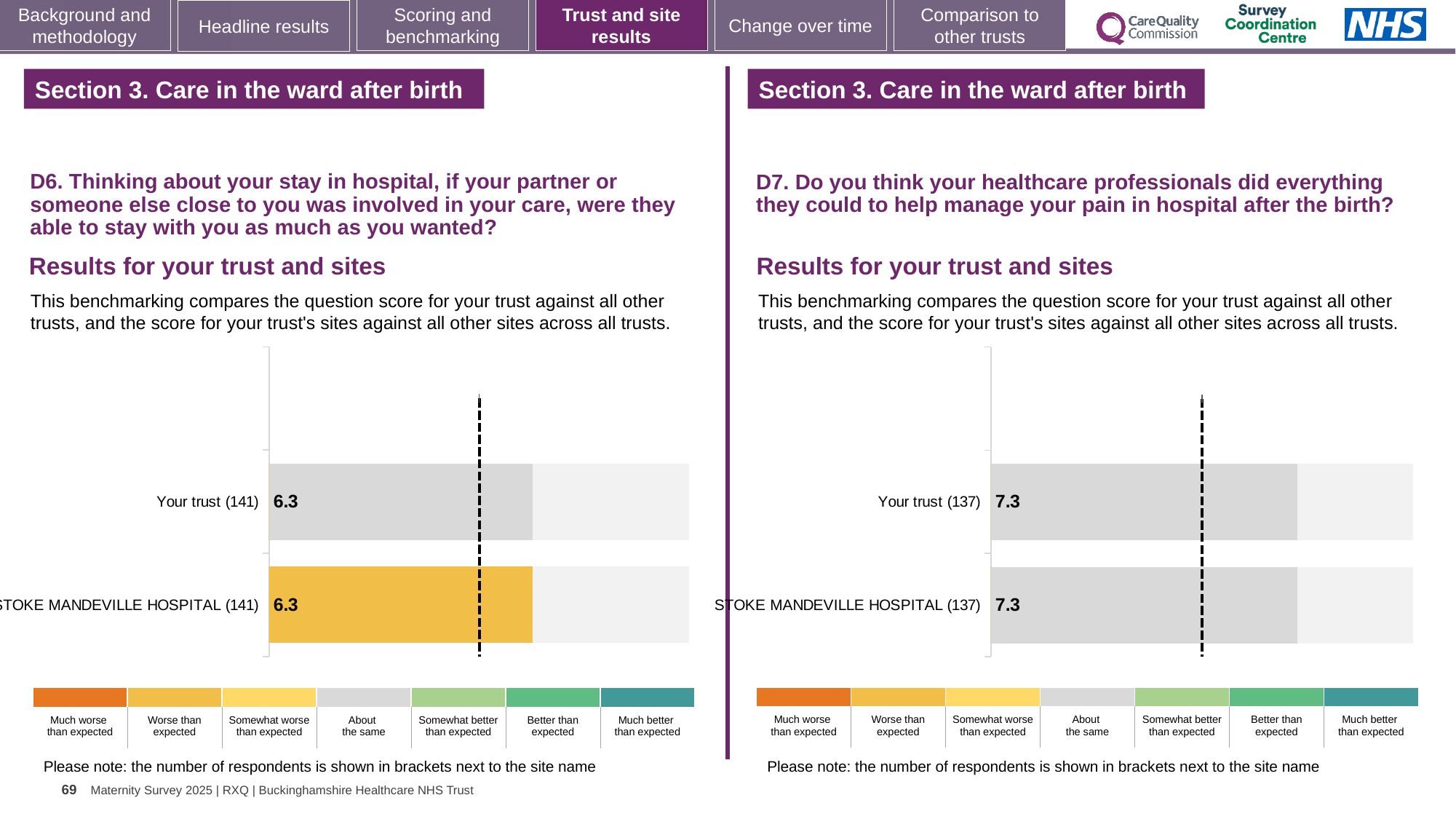
On the left chart (D6), how many respondents are shown in brackets next to Your trust? 141 On the right chart (D7), what is the score for Your trust? 7.3 On the left chart (D6), what is the score for Stoke Mandeville Hospital? 6.3 What kind of chart is used on the left (D6)? Bar chart On the right chart (D7), how many respondents are shown in brackets next to Stoke Mandeville Hospital? 137 How many bars are plotted on the right chart (D7)? 2 On the right chart (D7), what is the score for Stoke Mandeville Hospital? 7.3 On the left chart (D6), what is the score for Your trust? 6.3 On the right chart (D7), what is the difference between the score for Your trust and the score for Stoke Mandeville Hospital? 0.0 How many bars are plotted on the left chart (D6)? 2 On the left chart (D6), what is the difference between the score for Your trust and the score for Stoke Mandeville Hospital? 0.0 On the left chart (D6), which benchmark category does the colour of the Stoke Mandeville Hospital bar correspond to in the key? Worse than expected